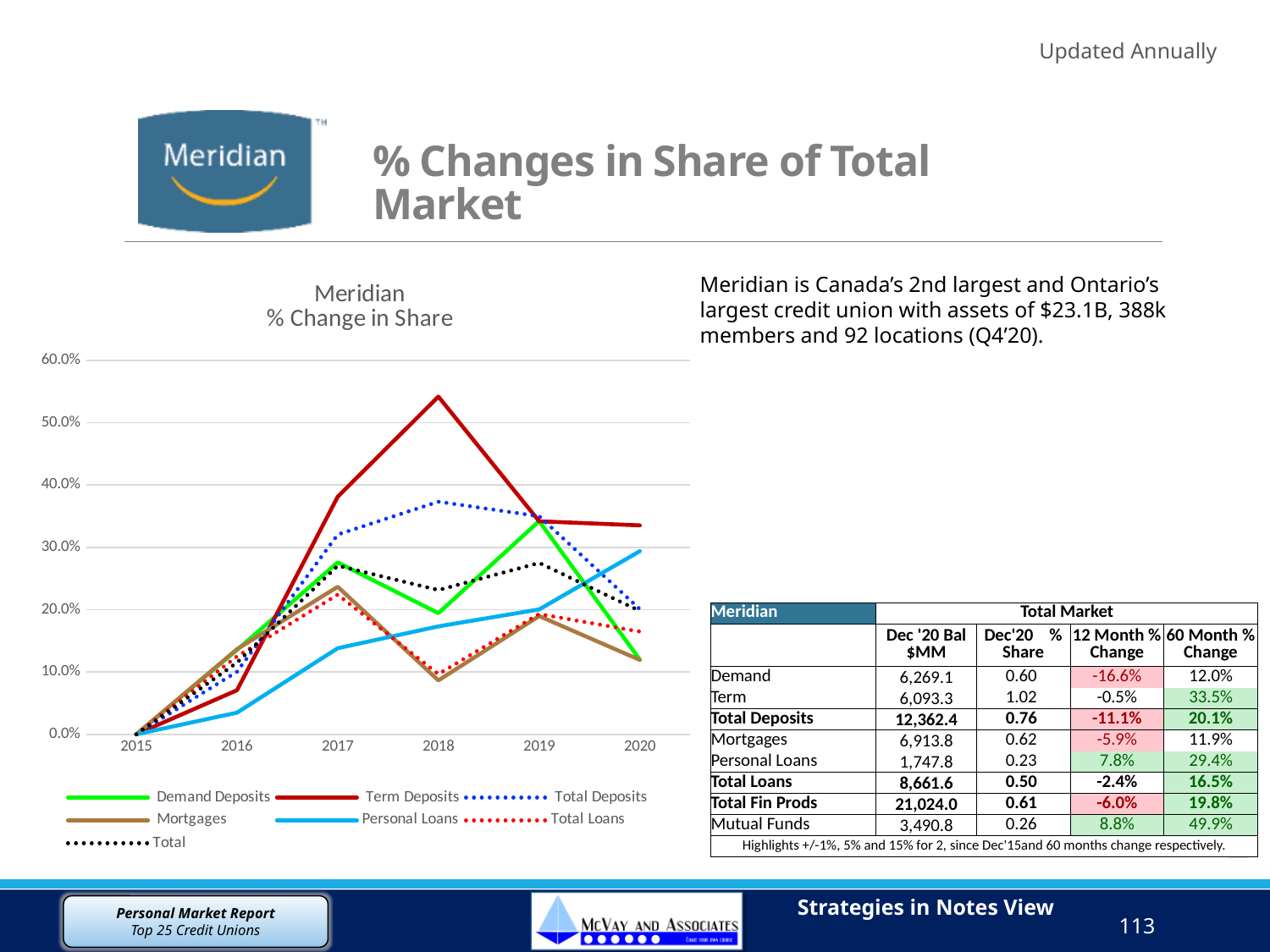
Does the Term Deposits line rise or fall from 2018 to 2020? fall How many series does the chart legend list? 7 In 2018, which is larger: Term Deposits or Demand Deposits? Term Deposits Is the value for Total Deposits in 2018 greater or less than 30%? greater Which series has the highest value in 2018? Term Deposits How many years are plotted along the x axis of the chart? 6 Is the value for Mortgages in 2018 greater or less than 10%? less Is the value for Term Deposits in 2016 greater or less than 10%? less What kind of chart is shown on the slide? line chart What is the title of the chart? Meridian % Change in Share What is the value for Demand Deposits in 2015? 0.0%